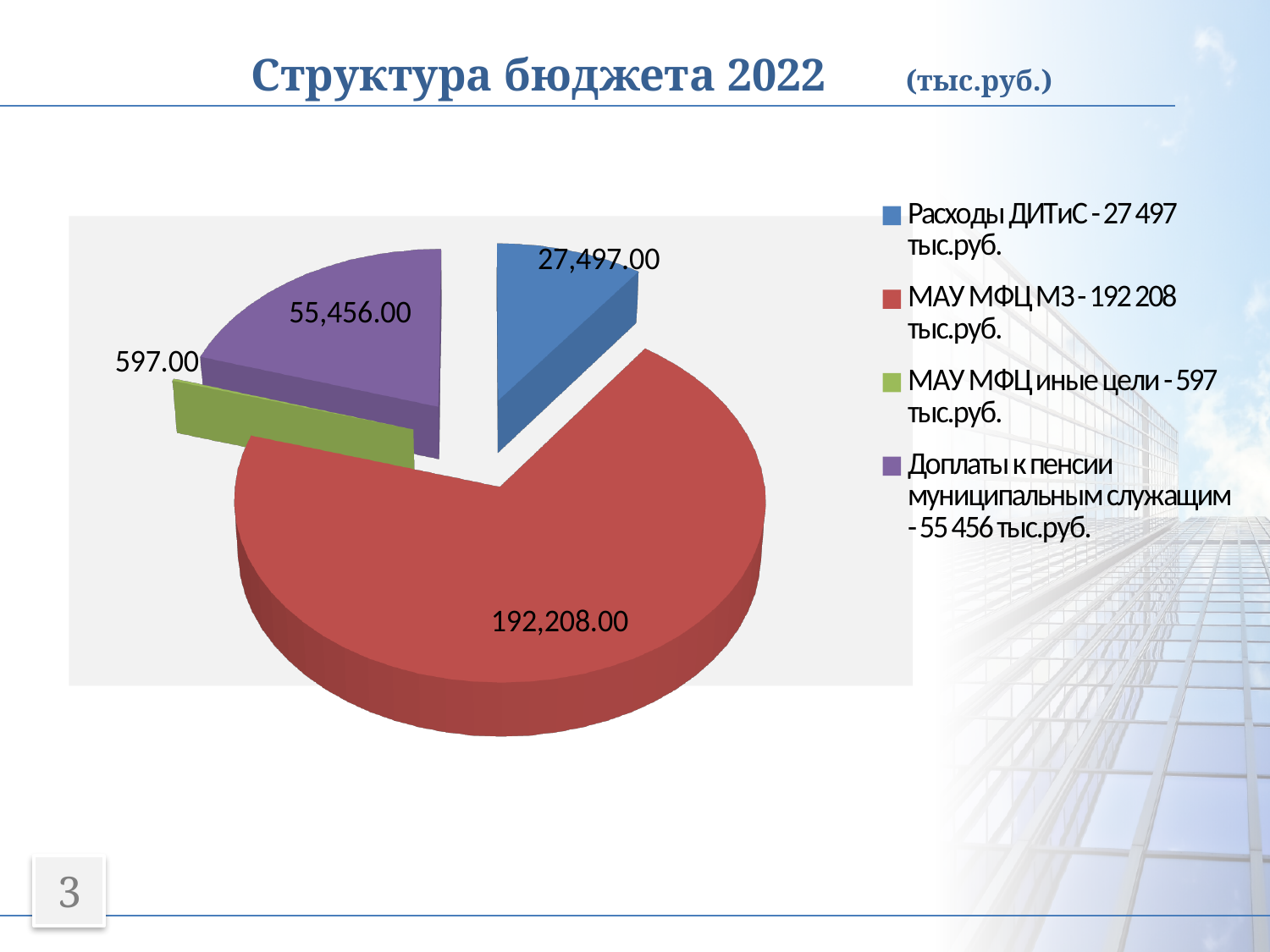
What is the difference between the values for МАУ МФЦ МЗ and Доплаты к пенсии муниципальным служащим? 136,752.00 What is the value for МАУ МФЦ МЗ? 192,208.00 What is the value for Расходы ДИТиС? 27,497.00 How many slices does the pie chart have? 4 What type of chart is shown on the slide? Pie chart Which category has the smallest slice of the pie? МАУ МФЦ иные цели What colour is the slice for МАУ МФЦ МЗ? Red What is the value for Доплаты к пенсии муниципальным служащим? 55,456.00 What is the value for МАУ МФЦ иные цели? 597.00 Which is larger: the value for Расходы ДИТиС or the value for Доплаты к пенсии муниципальным служащим? Доплаты к пенсии муниципальным служащим What is the total of all slices in the pie chart? 275,758.00 Which category has the largest slice of the pie? МАУ МФЦ МЗ